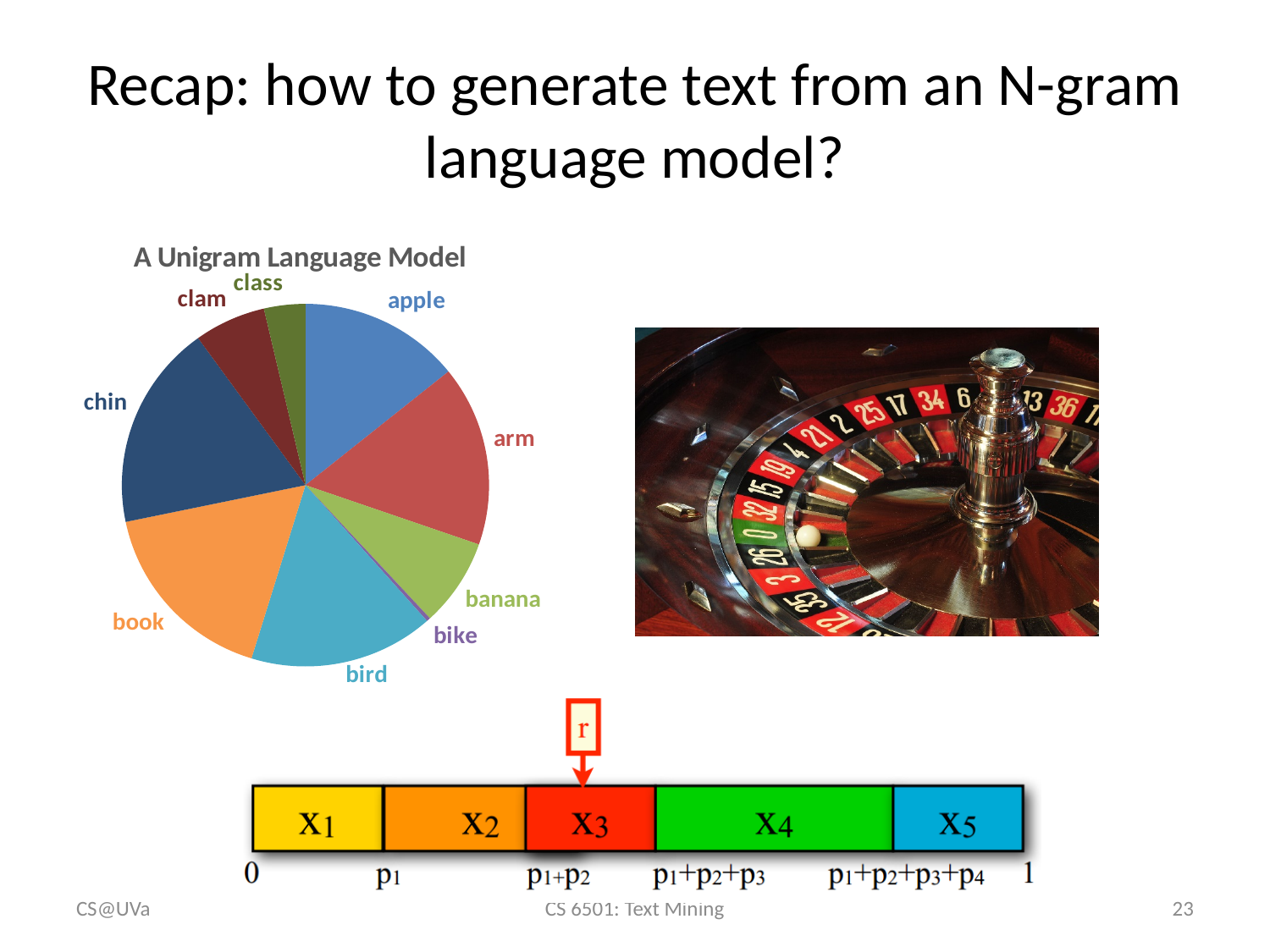
How many slices does the pie chart have? 9 What kind of chart is shown on the left of the slide? pie chart In the pie chart, which slice is larger, book or clam? book Which slice of the pie chart is the smallest? bike In the pie chart, which slice is larger, banana or bike? banana In the pie chart, which slice is larger, apple or class? apple What is the title of the pie chart? A Unigram Language Model What colour is the apple slice in the pie chart? blue